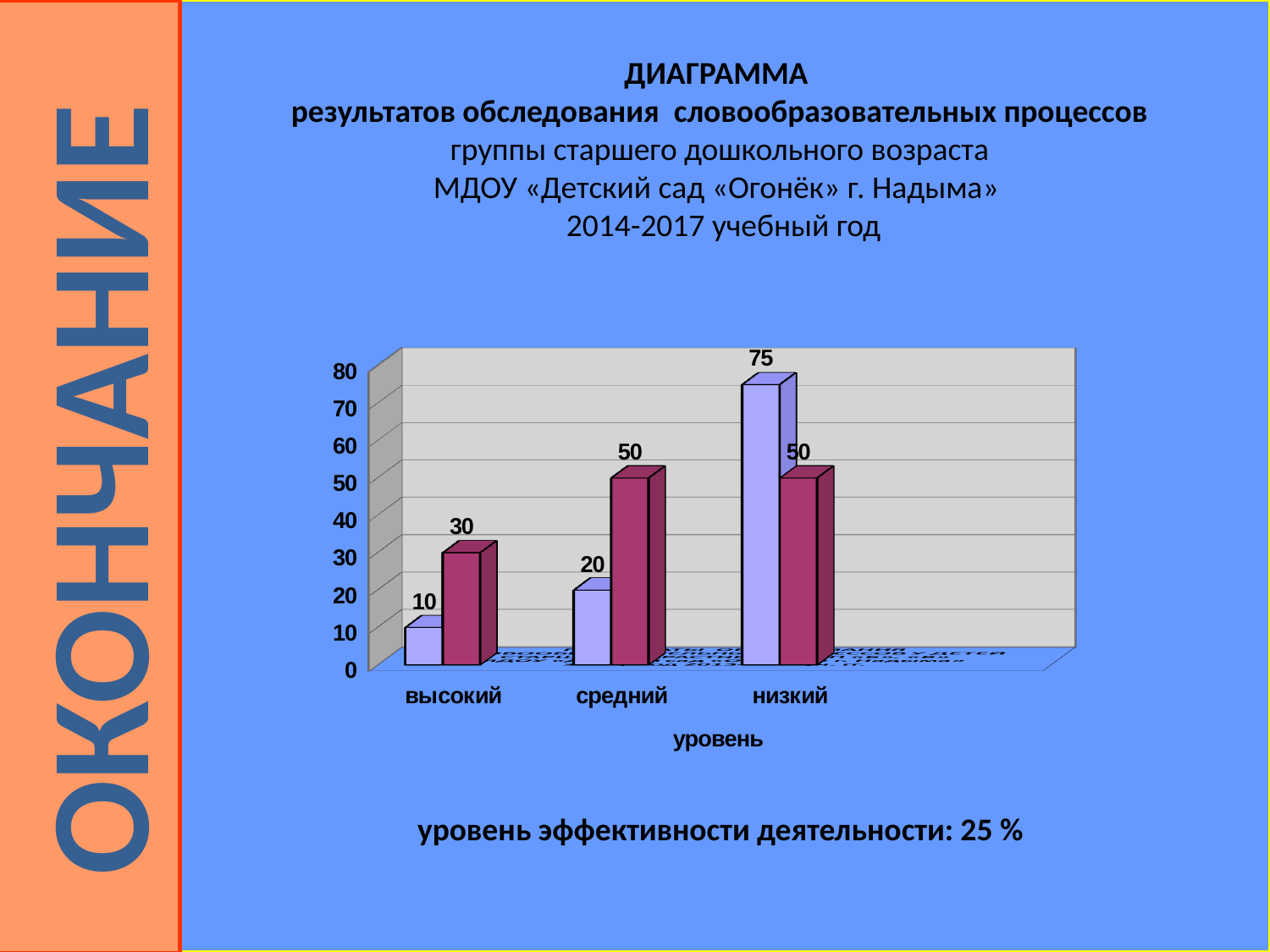
How many categories are shown on the x axis of the chart? 3 What is the value of the dark magenta bar for the category 'высокий'? 30 What type of chart is shown on the slide? bar chart For the category 'средний', which bar is larger: the light purple one or the dark magenta one? the dark magenta one Which category has the highest light purple bar? низкий What is the value of the light purple bar for the category 'средний'? 20 What is the label of the x axis of the chart? уровень What is the difference between the light purple bar and the dark magenta bar for the category 'низкий'? 25 What is the value of the light purple bar for the category 'высокий'? 10 What is the value of the dark magenta bar for the category 'низкий'? 50 Do the light purple bars rise or fall from 'высокий' to 'низкий'? rise Which category has the lowest dark magenta bar? высокий